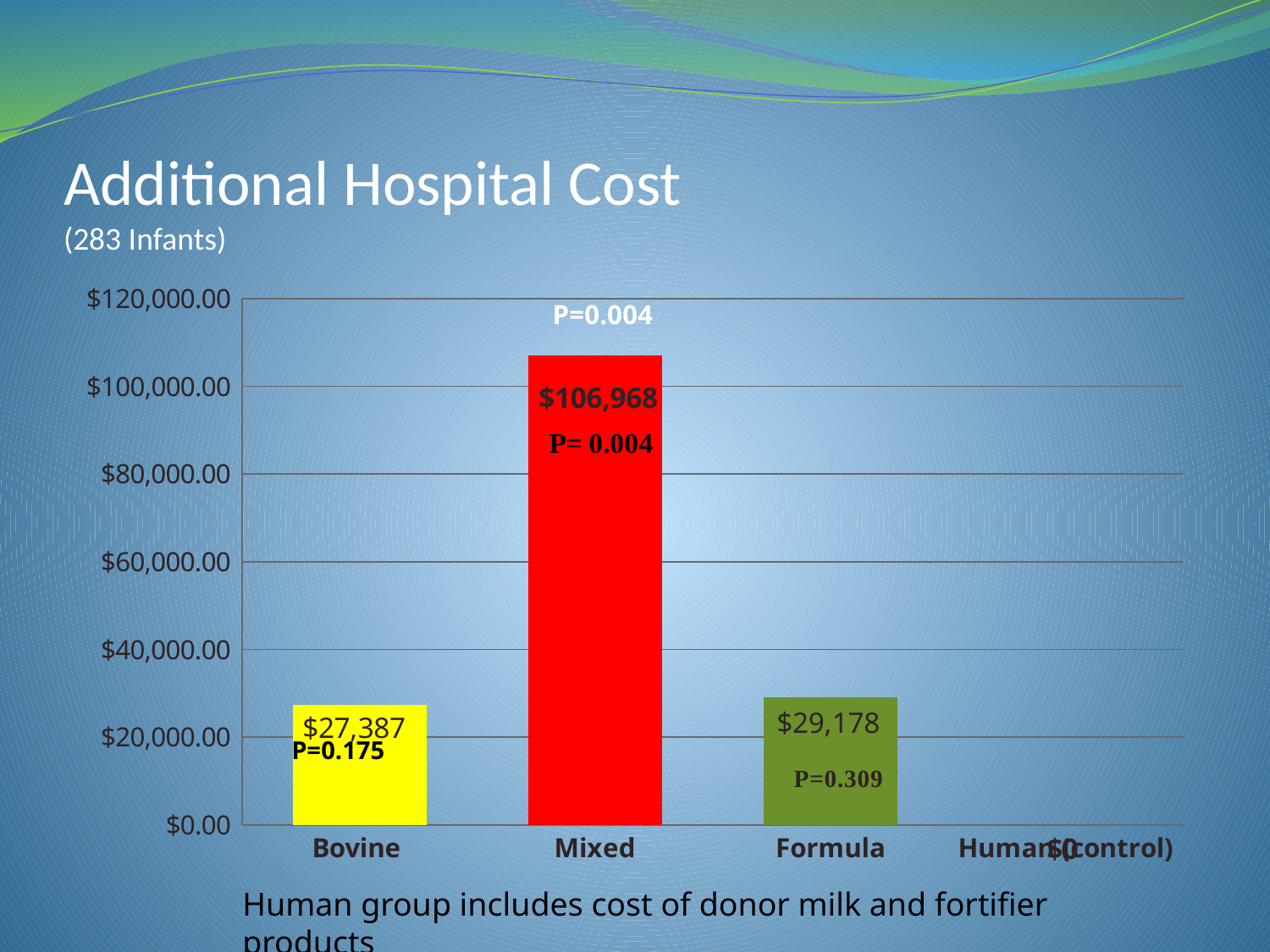
What is the additional hospital cost for the Human (control) group? $0 Which group has the highest additional hospital cost? Mixed What is the additional hospital cost for the Mixed group? $106,968 What is the difference in additional hospital cost between the Mixed and Formula groups? $77,790 How many groups are shown on the chart? 4 What is the difference in additional hospital cost between the Formula and Bovine groups? $1,791 What is the additional hospital cost for the Bovine group? $27,387 Is the additional hospital cost for the Mixed group greater or less than $100,000.00? greater Which group has the lowest additional hospital cost? Human (control) What is the additional hospital cost for the Formula group? $29,178 Which group has a larger additional hospital cost, Bovine or Mixed? Mixed What type of chart is shown on the slide? Bar chart